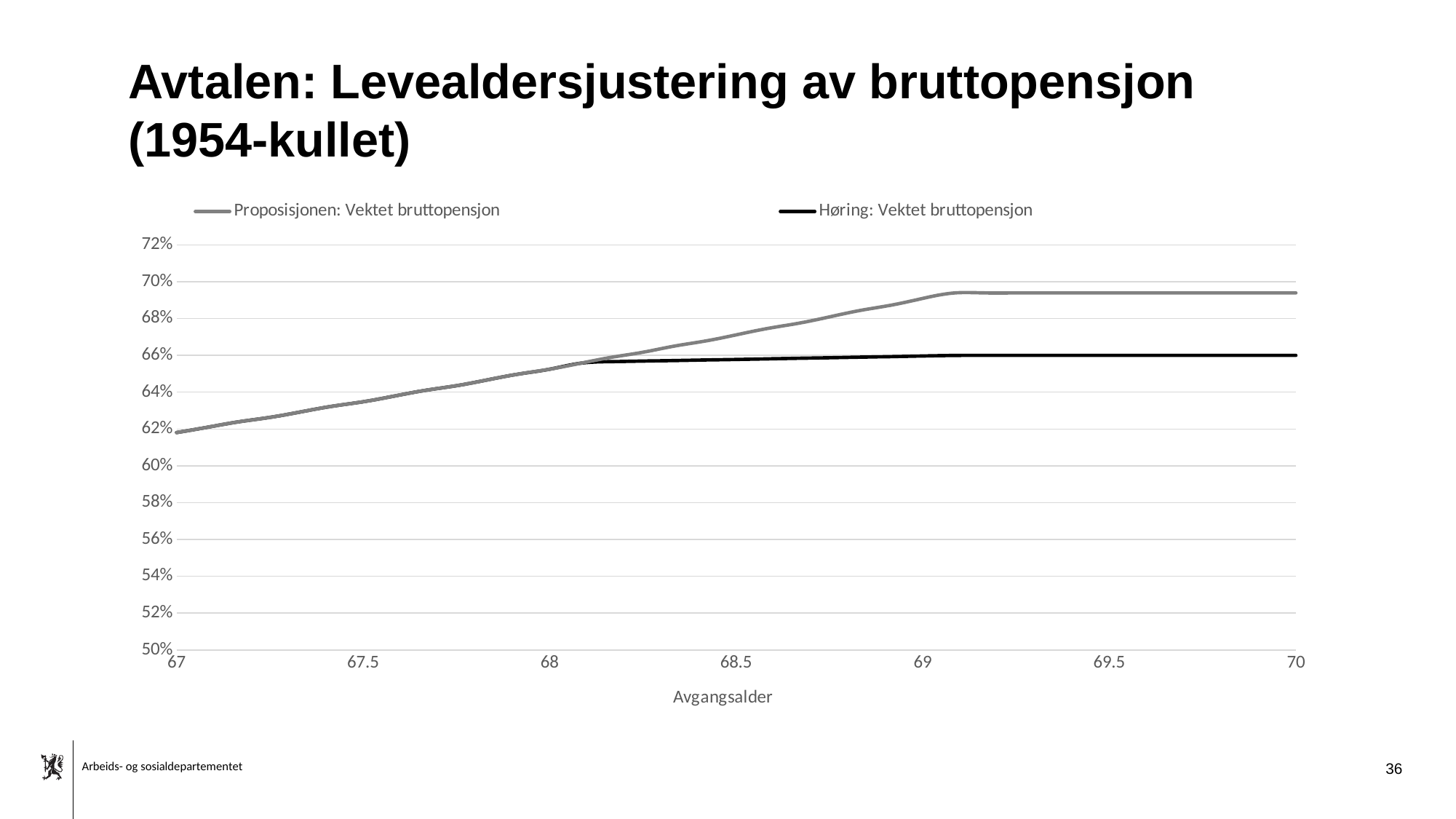
What kind of chart is shown on the slide? line chart Is the value for Proposisjonen: Vektet bruttopensjon at avgangsalder 67 greater or less than 64%? less At avgangsalder 70, which series has the higher value, Proposisjonen: Vektet bruttopensjon or Høring: Vektet bruttopensjon? Proposisjonen: Vektet bruttopensjon What are the two series named in the legend? Proposisjonen: Vektet bruttopensjon; Høring: Vektet bruttopensjon How many series does the legend list? 2 Is the value for Høring: Vektet bruttopensjon at avgangsalder 69 greater or less than 64%? greater Is the value for Høring: Vektet bruttopensjon at avgangsalder 70 greater or less than 68%? less Does the Høring: Vektet bruttopensjon line rise, fall or stay flat between avgangsalder 69 and 70? stay flat What is the title of the x axis? Avgangsalder Does the Proposisjonen: Vektet bruttopensjon line rise or fall from avgangsalder 67 to 69? rise